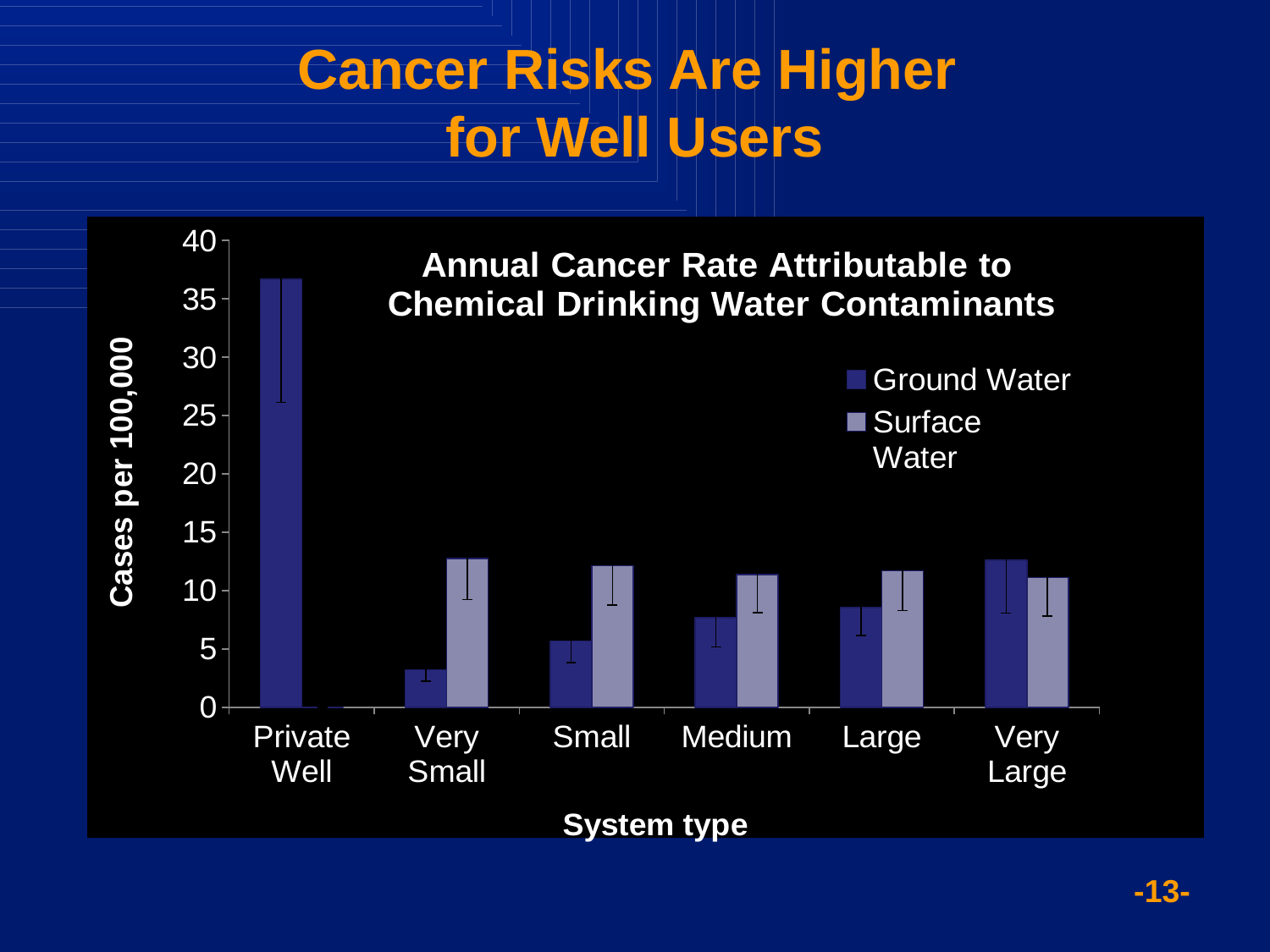
For Medium systems, which is larger, the Ground Water value or the Surface Water value? Surface Water Is the Surface Water value for Very Small greater or less than 10? greater How many series does the legend list? 2 Which system type has the highest Ground Water value? Private Well Which system type has the lowest Ground Water value? Very Small What is the label on the y axis of the chart? Cases per 100,000 What kind of chart is shown on the slide? bar chart Is the Ground Water value for Very Small greater or less than 5? less How many system type categories are shown on the x axis? 6 Is the Ground Water value for Private Well greater or less than 35? greater Which system type has the lowest Surface Water value? Private Well Do the Ground Water values rise or fall from Very Small to Very Large along the x axis? rise